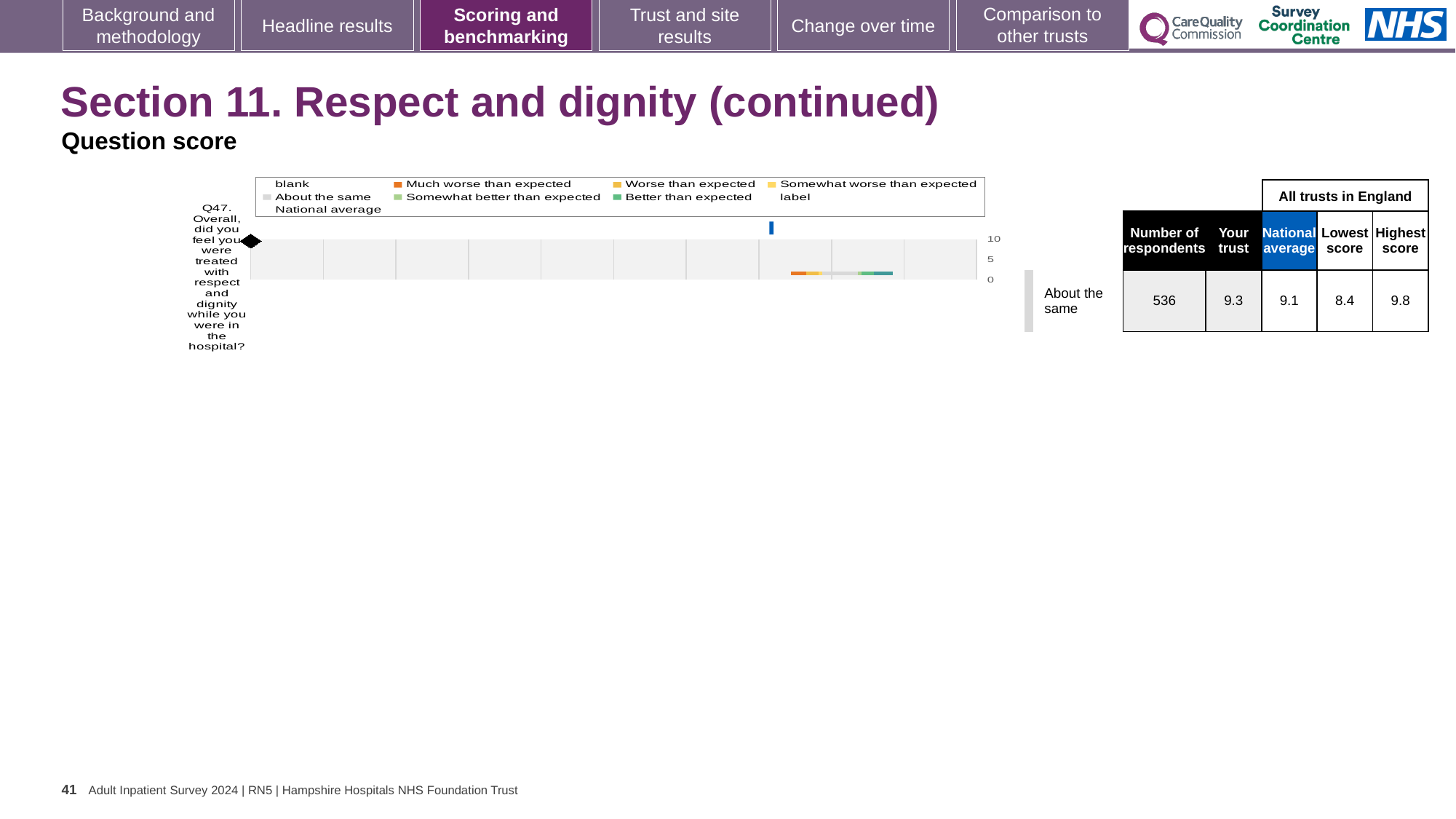
Which is larger for Q47: the 'Your trust' score or the national average? Your trust Which survey question does the chart on the slide plot? Q47. Overall, did you feel you were treated with respect and dignity while you were in the hospital? What is the 'Your trust' score for Q47 shown on the slide? 9.3 What is the national average score for Q47 shown on the slide? 9.1 What kind of chart is shown on the slide? bar chart What is the difference between the highest and lowest scores among all trusts in England for Q47? 1.4 How many respondents answered Q47 for this trust? 536 What is the highest tick value shown on the chart's score axis? 10 What is the difference between the 'Your trust' score and the national average for Q47? 0.2 Which benchmark category is the trust's Q47 result placed in? About the same What is the highest score among all trusts in England for Q47? 9.8 What is the lowest score among all trusts in England for Q47? 8.4